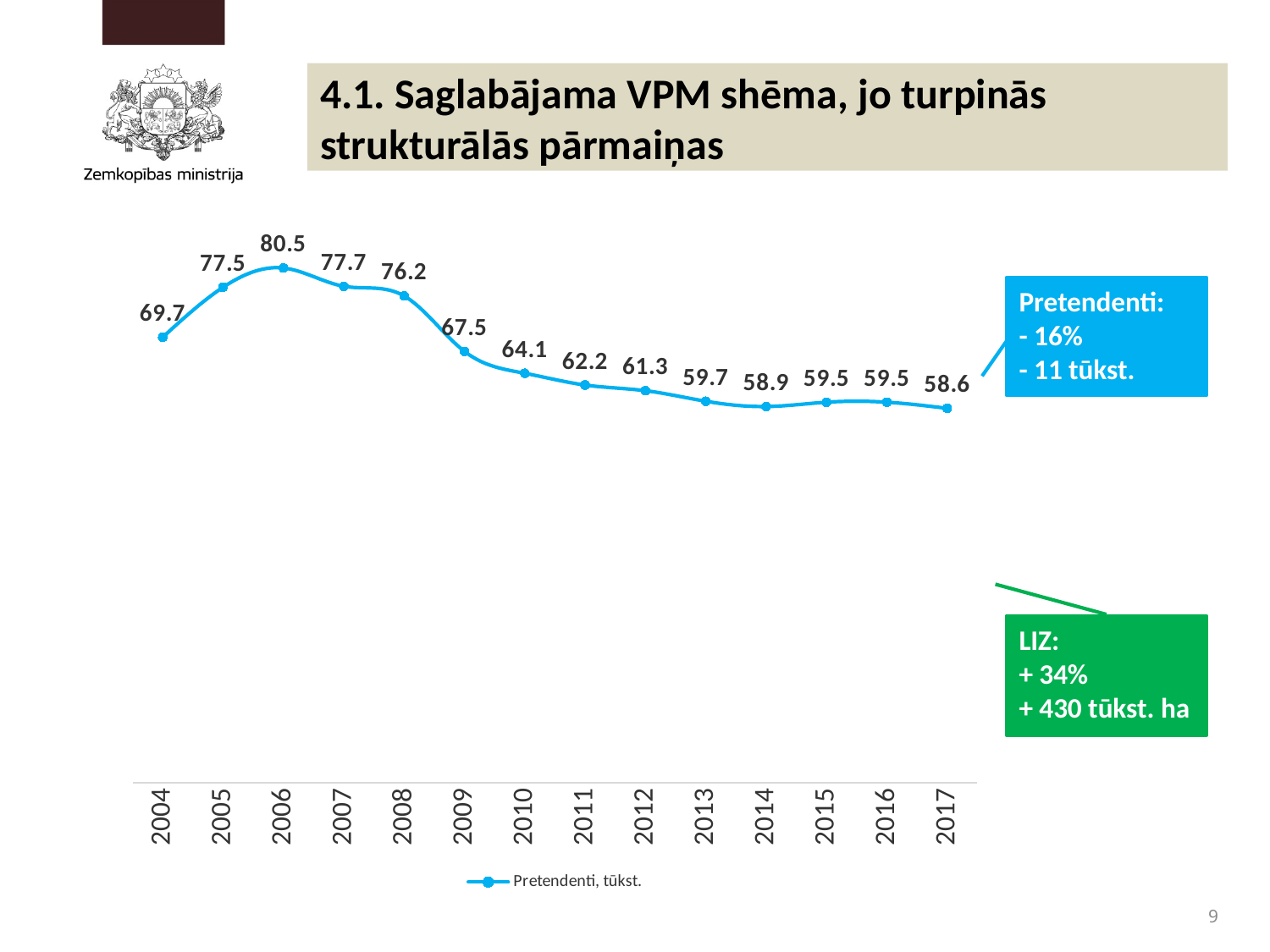
What is the value for 2009 in the line chart? 67.5 How many years are plotted on the x axis of the chart? 14 What kind of chart is shown on the slide? line chart What is the difference between the values for 2006 and 2017? 21.9 Which year has the lowest value in the line chart? 2017 Which year has a larger value, 2008 or 2010? 2008 Which year has the highest value in the line chart? 2006 How many series does the chart legend list? 1 What is the value for 2006 in the line chart? 80.5 Does the plotted value rise or fall from 2006 to 2017? fall What is the value for 2017 in the line chart? 58.6 What is the difference between the values for 2004 and 2005? 7.8